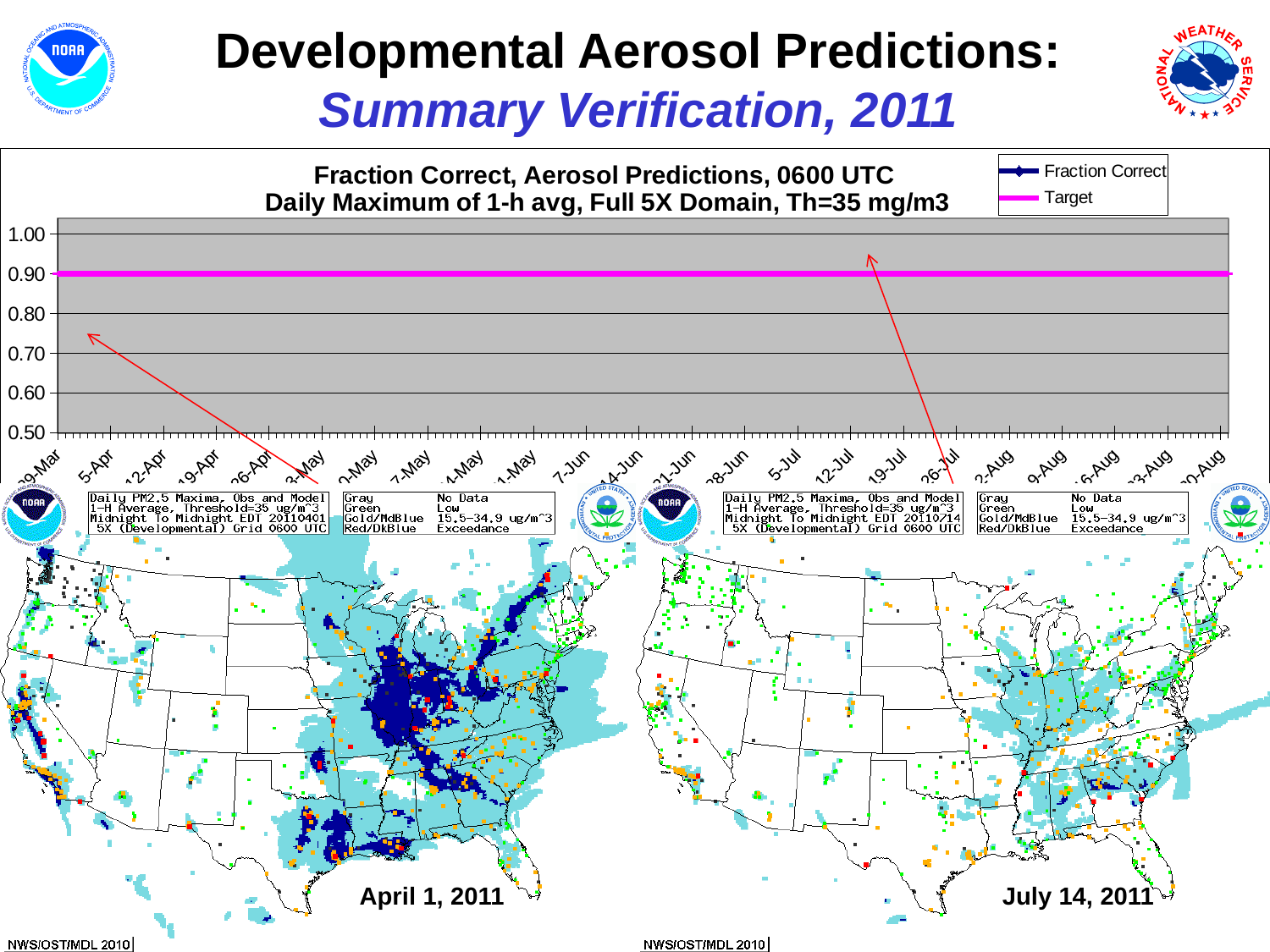
Is the Target line on the top chart greater or less than 1.00? less What colour is the Target line in the top chart? magenta What are the two entries in the legend of the top chart? Fraction Correct and Target Is the Target line on the top chart greater or less than 0.80? greater What is the lowest value shown on the y axis of the top chart? 0.50 What kind of chart is shown at the top of the slide? line chart At what value does the Target line sit on the top chart? 0.90 How many series does the legend of the top chart list? 2 Does the Target line rise, fall, or stay flat across the x axis of the top chart? stays flat